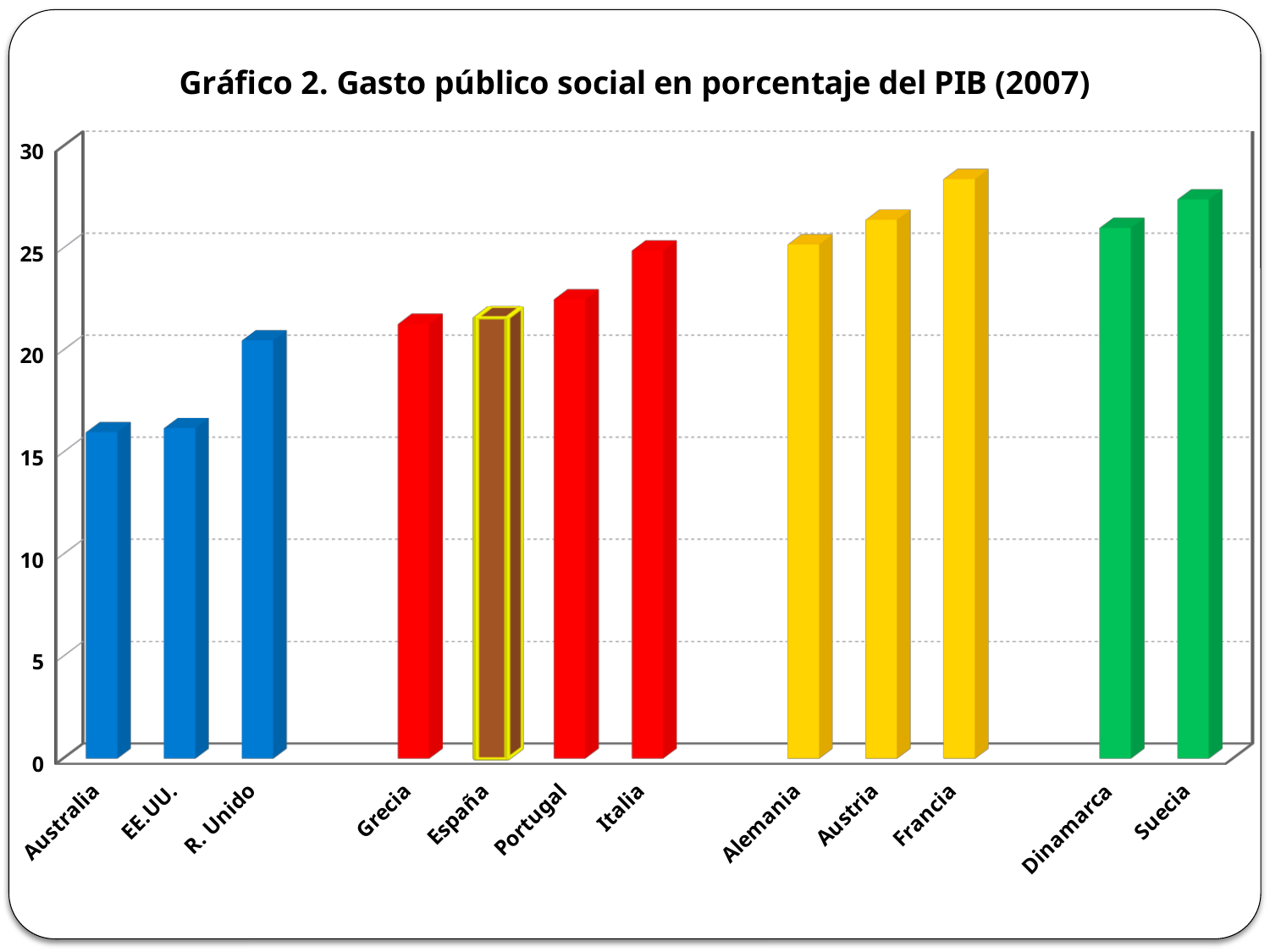
Is the value for Suecia greater or less than 25? greater How many countries are shown on the x axis of the chart? 12 Which country's bar is drawn in a different colour (brown with a yellow outline) from the others in its group? España Is the value for Australia greater or less than 20? less Which is larger, the value for Francia or the value for Suecia? Francia Which country has the highest public social spending as a percentage of GDP in the chart? Francia Which is larger, the value for Australia or the value for R. Unido? R. Unido What is the title of the chart? Gráfico 2. Gasto público social en porcentaje del PIB (2007) What kind of chart is shown on the slide? bar chart Is the value for Portugal greater or less than 25? less